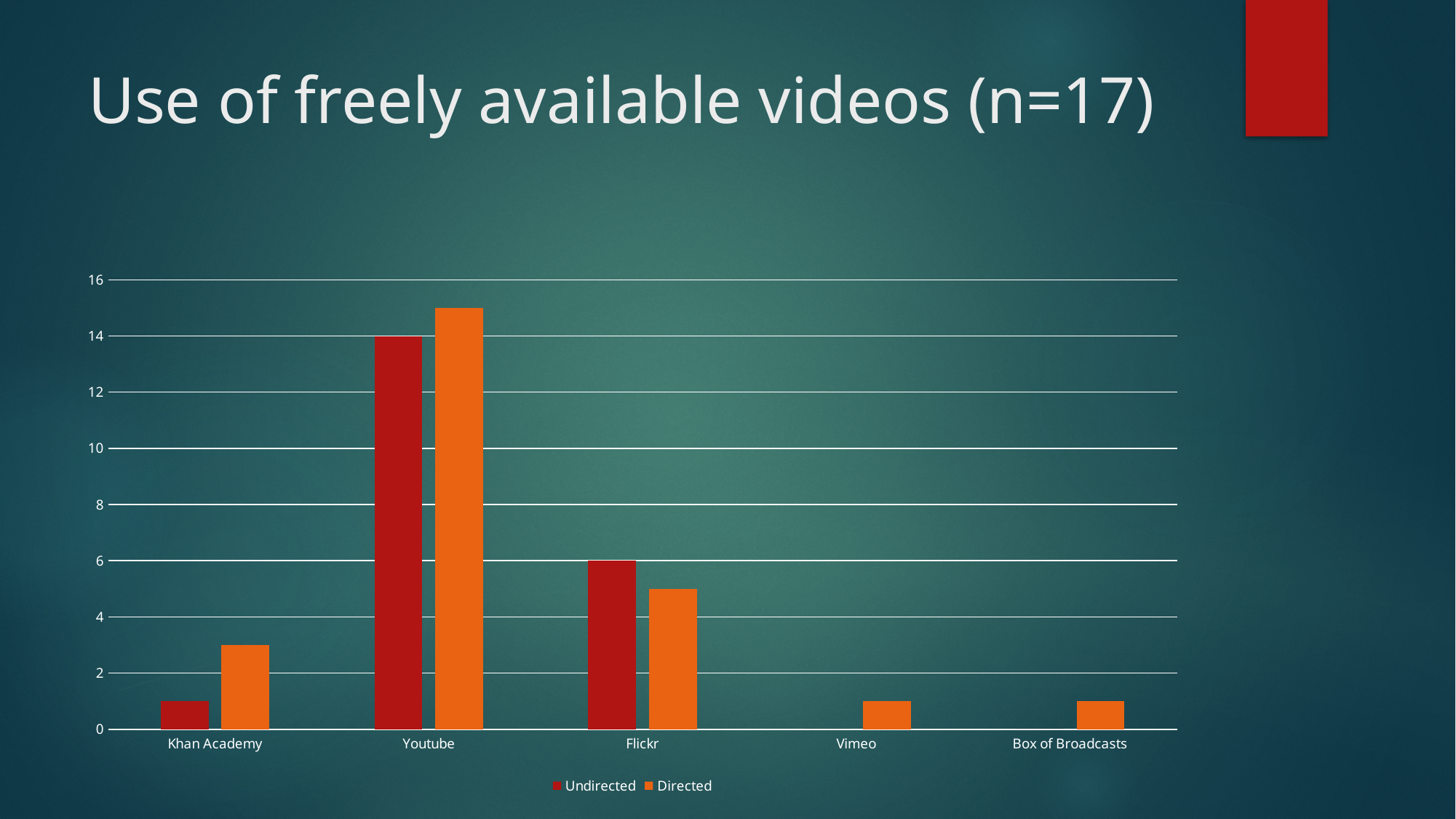
What type of chart is shown on the slide? bar chart Which category has the highest Undirected value? Youtube Is the Directed value for Khan Academy greater or less than 4? less Which colour represents the Directed series in the legend? orange How many series does the legend list? 2 What is the Undirected value for Flickr? 6 How many categories are shown on the x axis? 5 Which category has the highest Directed value? Youtube What is the Undirected value for Youtube? 14 What is the title of the chart? Use of freely available videos (n=17) Is the Directed value for Youtube greater or less than 14? greater For Flickr, which is larger, the Undirected value or the Directed value? Undirected